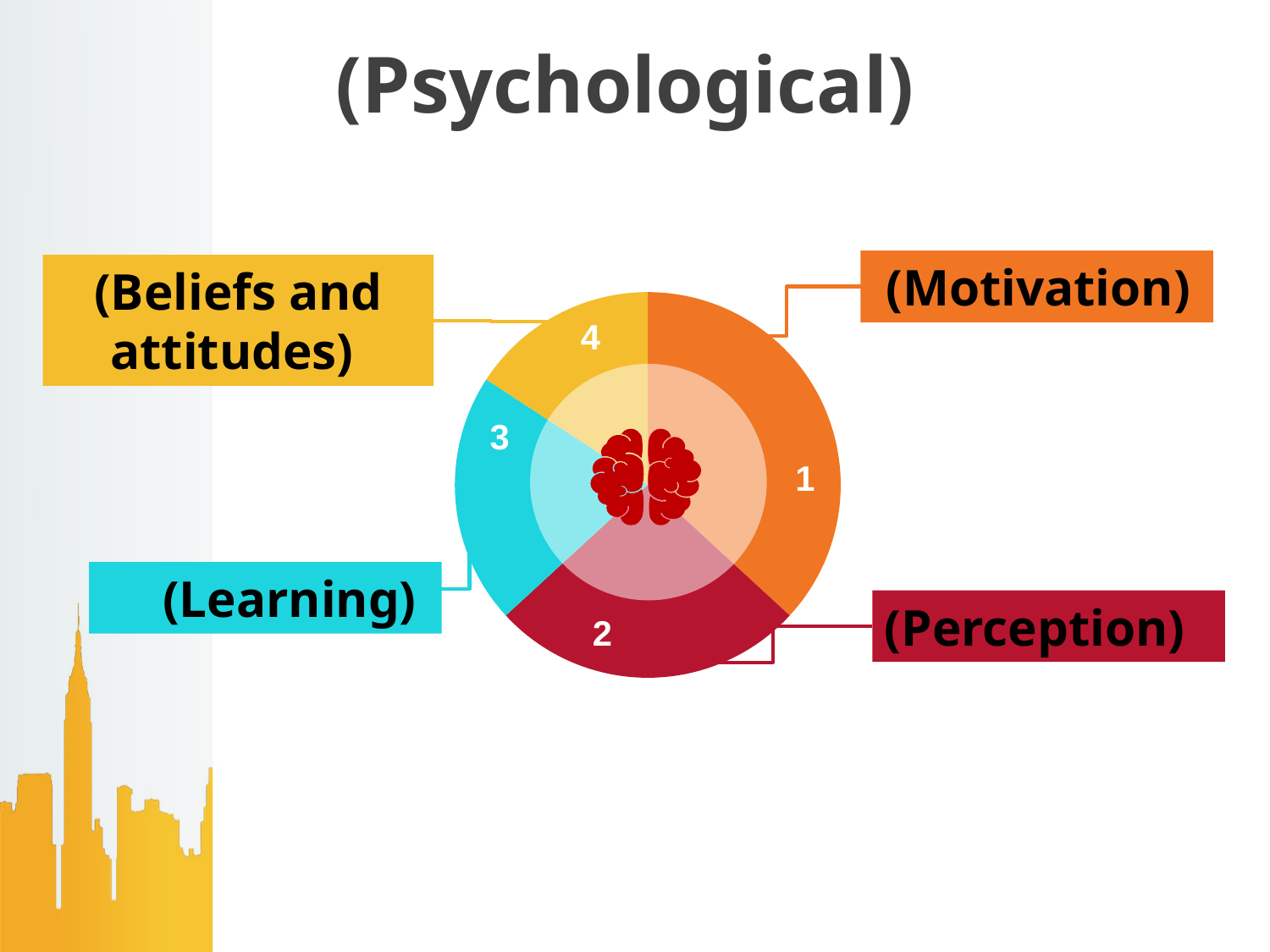
Which number is printed on the segment labelled (Perception)? 2 What is the title of the slide? (Psychological) Which label belongs to segment 2 of the diagram? (Perception) How many segments does the circular diagram have? 4 Which number is printed on the segment labelled (Motivation)? 1 What kind of chart is shown on the slide? pie chart Which number is printed on the segment labelled (Learning)? 3 What colour is the segment labelled (Learning)? blue Which number is printed on the segment labelled (Beliefs and attitudes)? 4